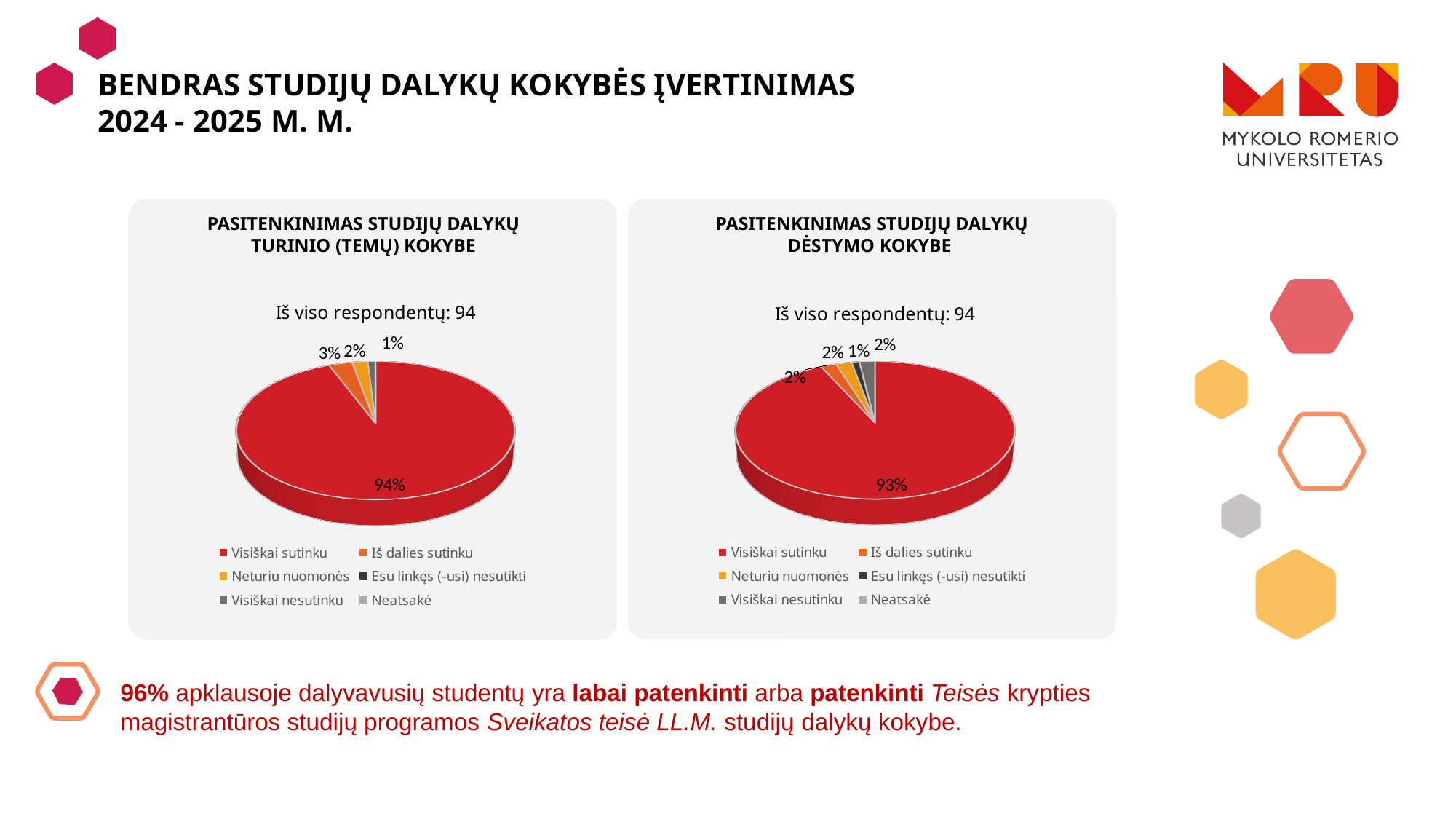
In the right chart, 'Pasitenkinimas studijų dalykų dėstymo kokybe', what share of respondents answered 'Visiškai sutinku'? 93% In the right chart, 'Pasitenkinimas studijų dalykų dėstymo kokybe', what share is labelled for 'Esu linkęs (-usi) nesutikti'? 1% In the left chart, 'Pasitenkinimas studijų dalykų turinio (temų) kokybe', what share of respondents answered 'Visiškai sutinku'? 94% What kind of chart is used in the left chart, 'Pasitenkinimas studijų dalykų turinio (temų) kokybe'? Pie chart In the left chart, 'Pasitenkinimas studijų dalykų turinio (temų) kokybe', what share is labelled for 'Neturiu nuomonės'? 2% What is the difference between the 'Visiškai sutinku' share in the left chart (94%) and in the right chart (93%)? 1 percentage point Is the 'Visiškai sutinku' share larger in the left chart (turinio kokybe) or in the right chart (dėstymo kokybe)? Left chart (turinio kokybe) In the left chart, 'Pasitenkinimas studijų dalykų turinio (temų) kokybe', which category has the largest slice? Visiškai sutinku In the left chart, 'Pasitenkinimas studijų dalykų turinio (temų) kokybe', what share is labelled for 'Iš dalies sutinku'? 3% How many entries does the legend of the left chart, 'Pasitenkinimas studijų dalykų turinio (temų) kokybe', list? 6 How many respondents does the right chart, 'Pasitenkinimas studijų dalykų dėstymo kokybe', report in total? 94 In the right chart, 'Pasitenkinimas studijų dalykų dėstymo kokybe', which category has the largest slice? Visiškai sutinku